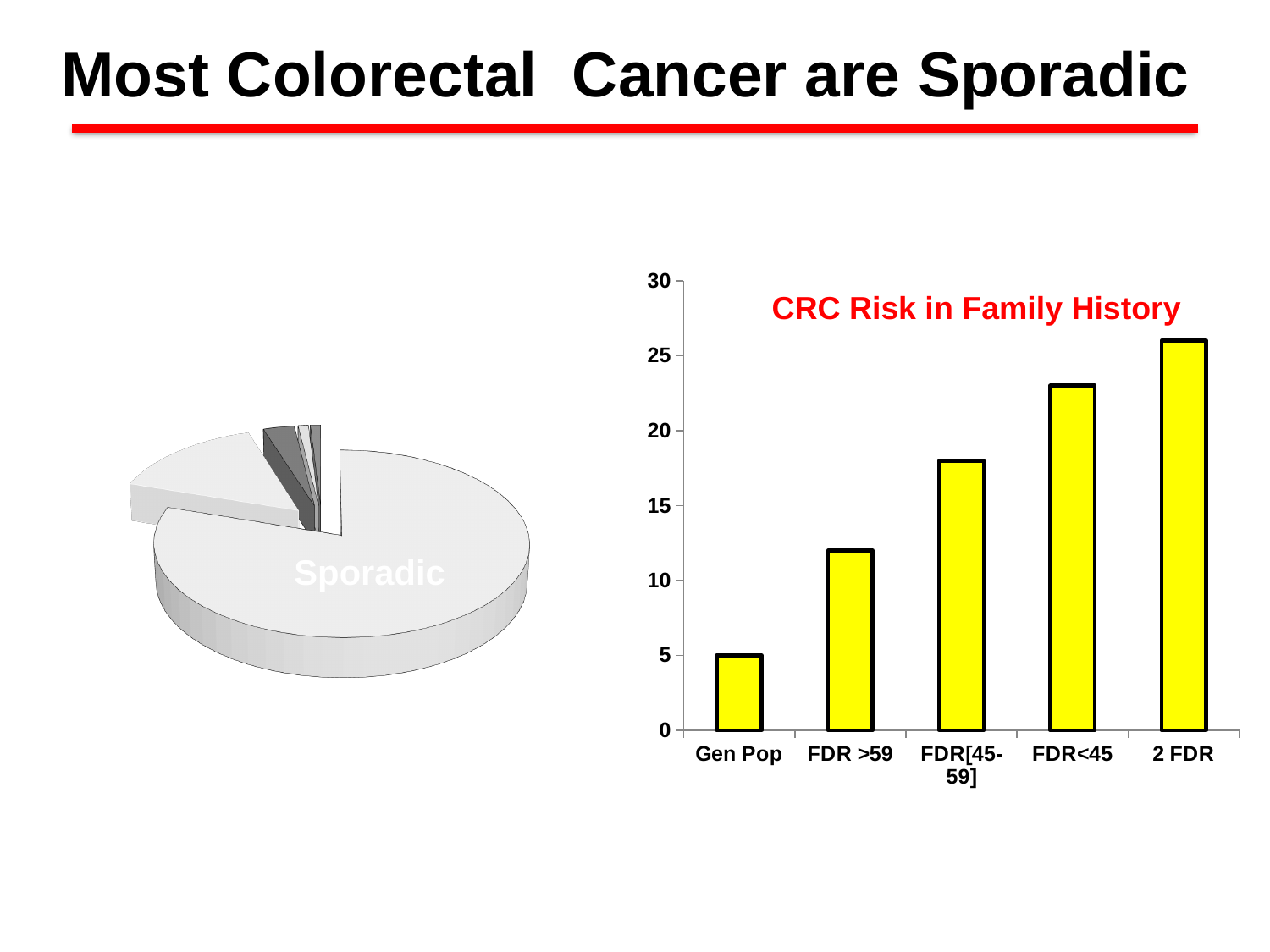
In the "CRC Risk in Family History" chart, do the values rise or fall from left to right along the x axis? rise In the "CRC Risk in Family History" chart, which category has the lowest value? Gen Pop What kind of chart is the chart on the left of the slide? pie chart In the "CRC Risk in Family History" chart, is the value for FDR >59 greater or less than 10? greater In the "CRC Risk in Family History" chart, is the value for 2 FDR greater or less than 25? greater In the "CRC Risk in Family History" chart, what is the value for Gen Pop? 5 In the "CRC Risk in Family History" chart, is the value for FDR[45-59] greater or less than 20? less In the "CRC Risk in Family History" chart, which category has the highest value? 2 FDR What kind of chart is the chart on the right titled "CRC Risk in Family History"? bar chart In the pie chart on the left, what is the label on the largest slice? Sporadic In the "CRC Risk in Family History" chart, how many categories are shown on the x axis? 5 In the "CRC Risk in Family History" chart, which is larger, the value for FDR<45 or the value for FDR >59? FDR<45